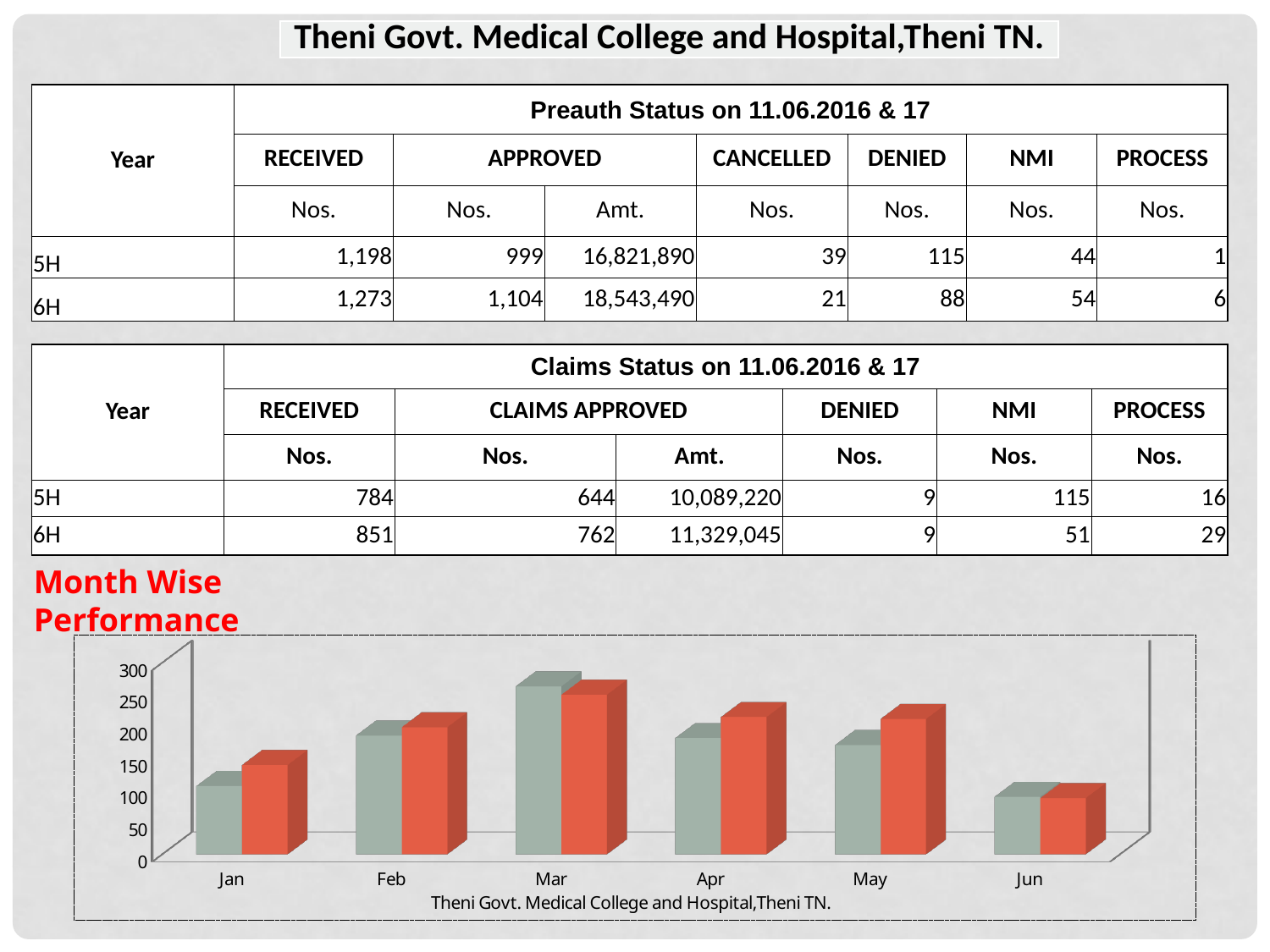
Is the grey bar for Jan greater or less than 150? less Do the grey bars rise or fall from Mar to Jun? fall Which month has the shortest grey bar in the bar chart? Jun Is the grey bar for Mar greater or less than 200? greater What kind of chart is shown under the 'Month Wise Performance' heading? bar chart Which month has the tallest red bar in the bar chart? Mar How many months are shown on the x axis of the bar chart? 6 Which month has the tallest grey bar in the bar chart? Mar Is the red bar for Jun greater or less than 150? less In Jan, which bar is taller, the grey bar or the red bar? the red bar What text appears below the x axis of the bar chart? Theni Govt. Medical College and Hospital,Theni TN.